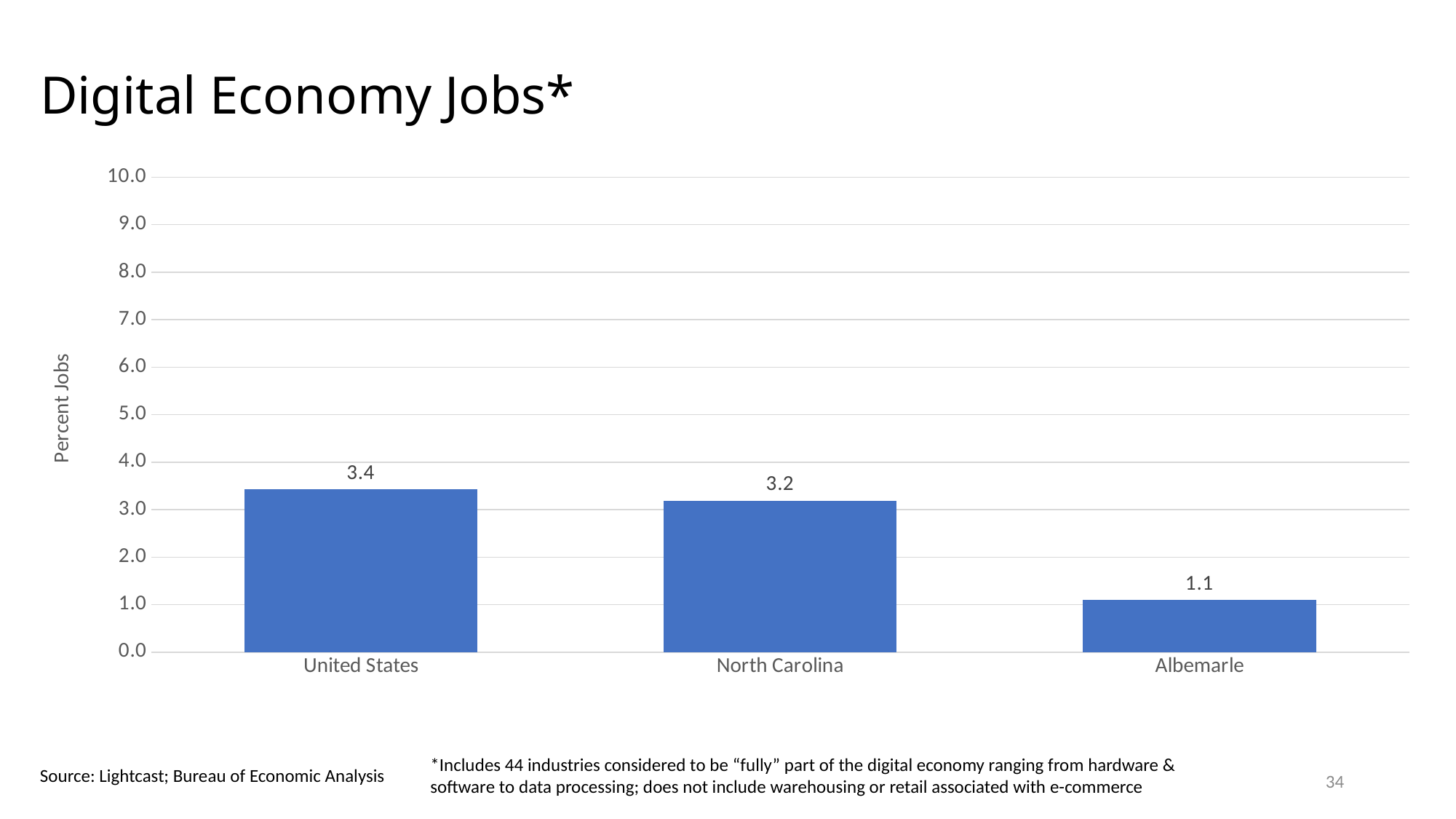
What kind of chart is shown on the slide? bar chart Which category has the lowest value? Albemarle What is the label of the vertical axis? Percent Jobs What is the difference between the values for United States and Albemarle? 2.3 What is the value for North Carolina? 3.2 How many categories are shown on the chart? 3 Which is larger, the value for North Carolina or the value for Albemarle? North Carolina What is the value for United States? 3.4 Is the value for Albemarle greater or less than 2.0? less What is the difference between the values for North Carolina and Albemarle? 2.1 What is the value for Albemarle? 1.1 Which category has the highest value? United States